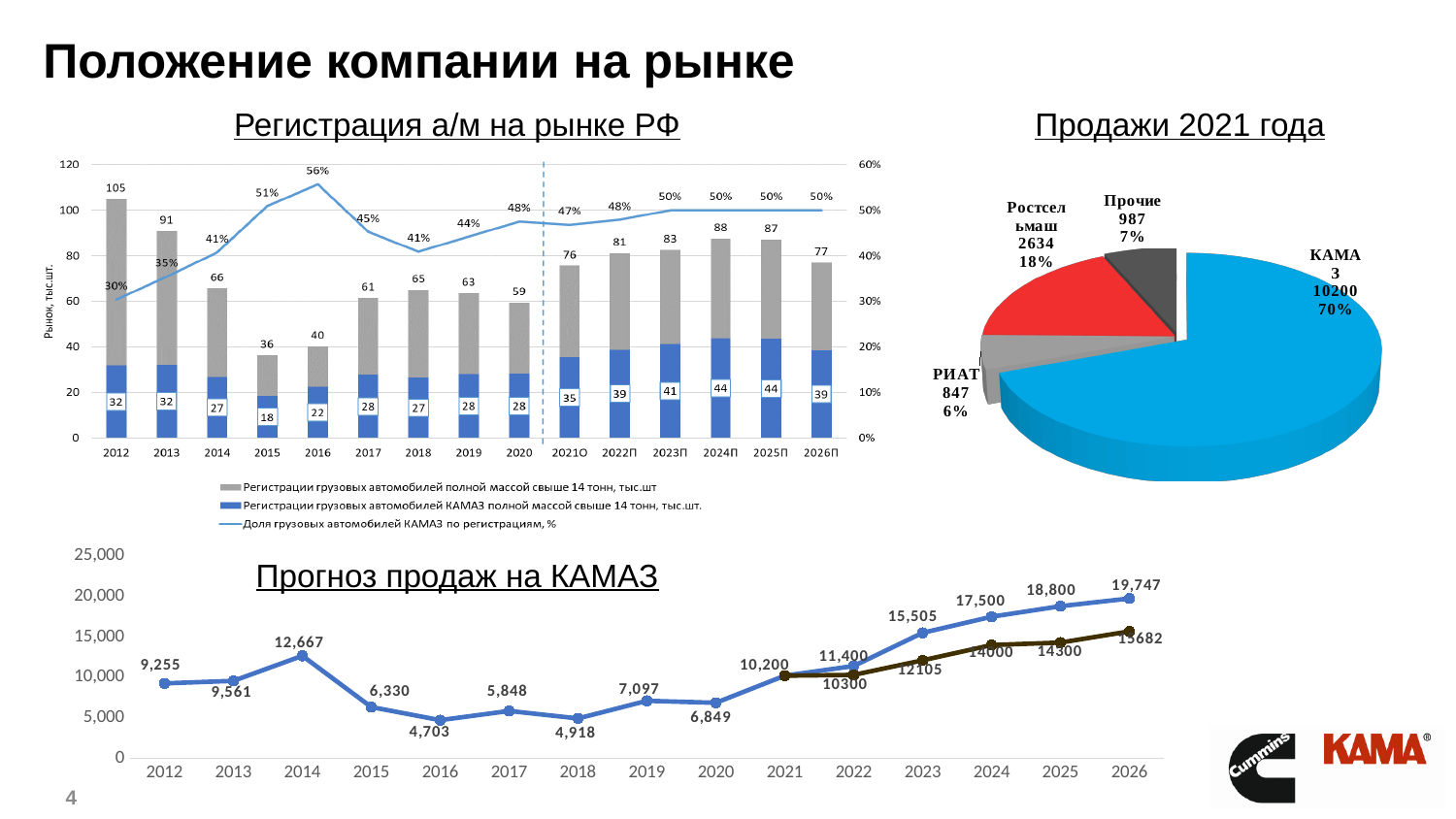
In the "Прогноз продаж на КАМАЗ" chart, what is the difference between the blue line values for 2024 (17,500) and 2023 (15,505)? 1,995 In the "Продажи 2021 года" pie chart, what is the value for Ростсельмаш? 2634 In the "Прогноз продаж на КАМАЗ" chart, what is the value for 2014? 12,667 In the "Регистрация а/м на рынке РФ" chart, what is the KAMAZ registrations value (blue bar) for 2015? 18 In the "Регистрация а/м на рынке РФ" chart, in which year is the KAMAZ share line at its highest? 2016 In the "Продажи 2021 года" pie chart, which slice is the smallest? РИАТ What kind of chart is "Прогноз продаж на КАМАЗ"? line chart In the "Регистрация а/м на рынке РФ" chart, what is the KAMAZ share (Доля) for 2016? 56% How many slices does the "Продажи 2021 года" pie chart have? 4 In the "Регистрация а/м на рынке РФ" chart, how many series does the legend list? 3 In the "Продажи 2021 года" pie chart, what share does КАМАЗ have? 70% In the "Прогноз продаж на КАМАЗ" chart, which year has the lowest value on the blue line? 2016